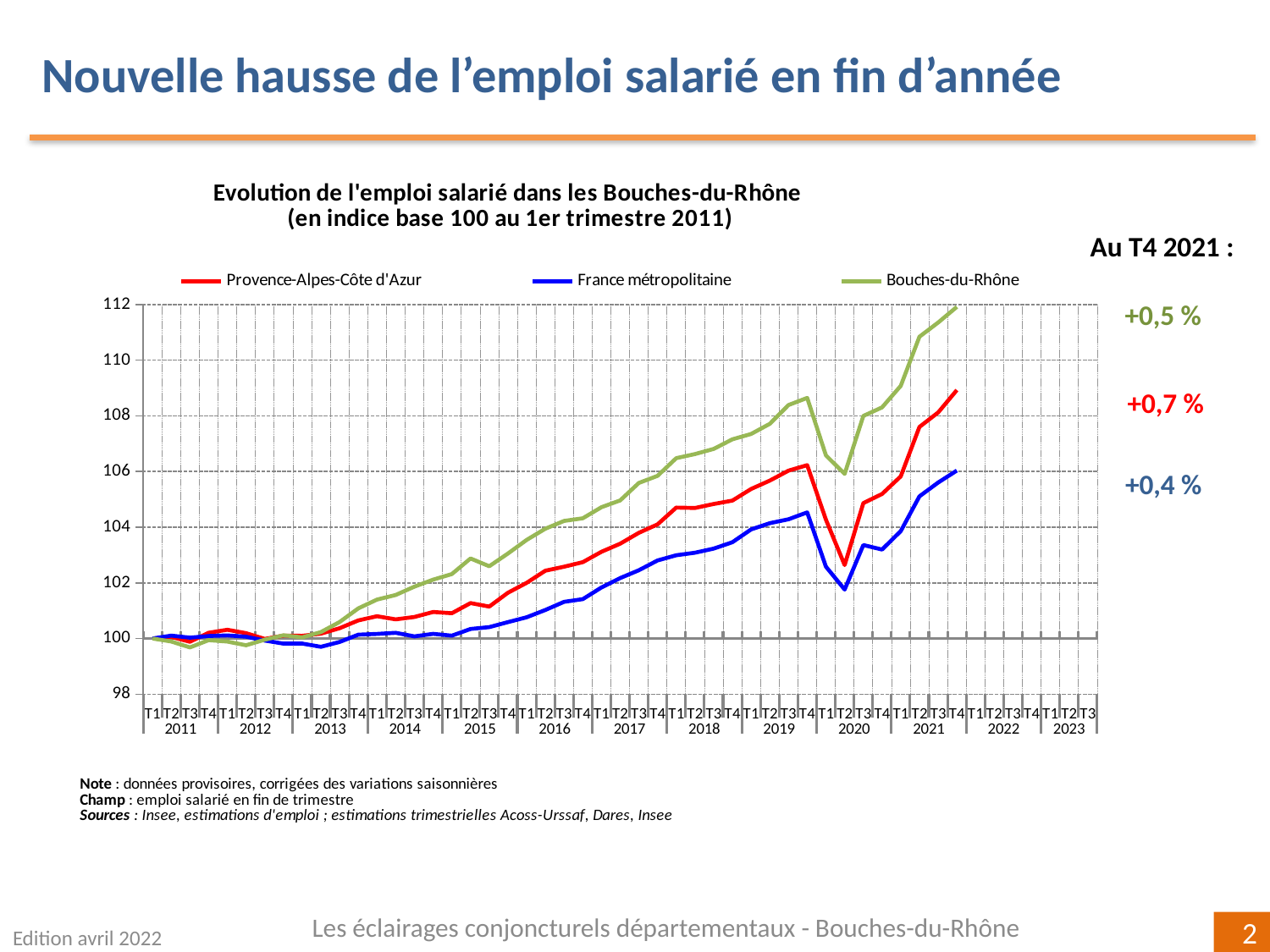
Is the value for Bouches-du-Rhône at T2 2020 greater or less than 108? less Which series is lowest at T4 2021? France métropolitaine Is the value for France métropolitaine at T4 2021 greater or less than 108? less What kind of chart is shown on the slide? line chart What change at T4 2021 is annotated for Provence-Alpes-Côte d'Azur? +0,7 % At T4 2021, which is larger: Provence-Alpes-Côte d'Azur or France métropolitaine? Provence-Alpes-Côte d'Azur What change at T4 2021 is annotated for Bouches-du-Rhône? +0,5 % Which series is highest at T4 2021? Bouches-du-Rhône How many series does the legend list? 3 What is the title of the chart? Evolution de l'emploi salarié dans les Bouches-du-Rhône (en indice base 100 au 1er trimestre 2011) Is the value for Bouches-du-Rhône at T4 2021 greater or less than 110? greater Overall, do the series rise or fall from 2011 to 2021? rise